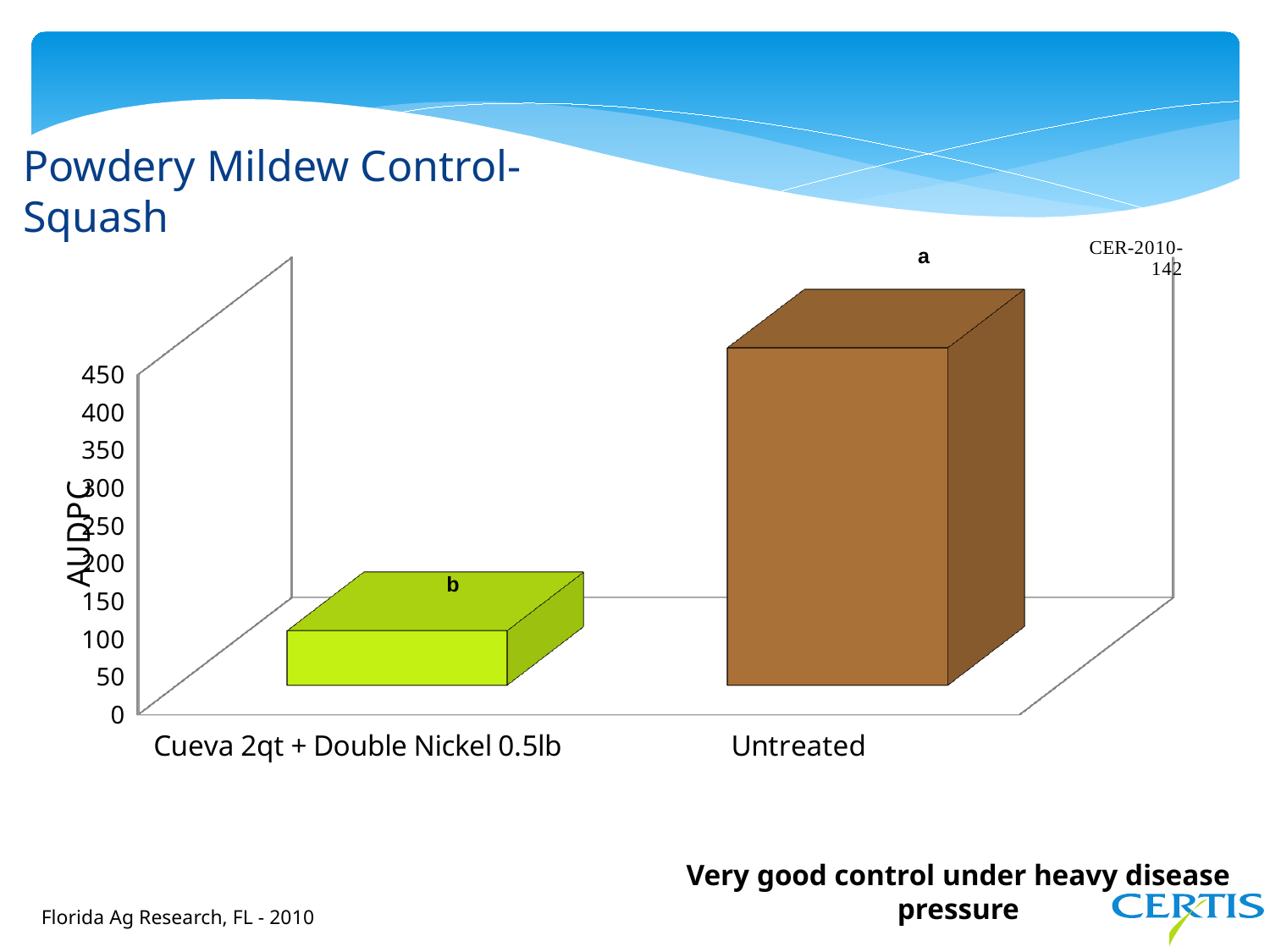
Is the AUDPC value for Untreated greater or less than 300? greater What is the label on the vertical axis of the chart? AUDPC What kind of chart is shown on the slide? bar chart Do the values rise or fall moving from left to right along the x axis? rise Is the AUDPC value for Cueva 2qt + Double Nickel 0.5lb greater or less than 200? less Which category has the lowest AUDPC value? Cueva 2qt + Double Nickel 0.5lb Which has a larger AUDPC value, Cueva 2qt + Double Nickel 0.5lb or Untreated? Untreated Which category has the highest AUDPC value? Untreated Is the AUDPC value for Cueva 2qt + Double Nickel 0.5lb greater or less than 150? less What is the title of the slide containing the chart? Powdery Mildew Control- Squash How many categories are plotted on the chart? 2